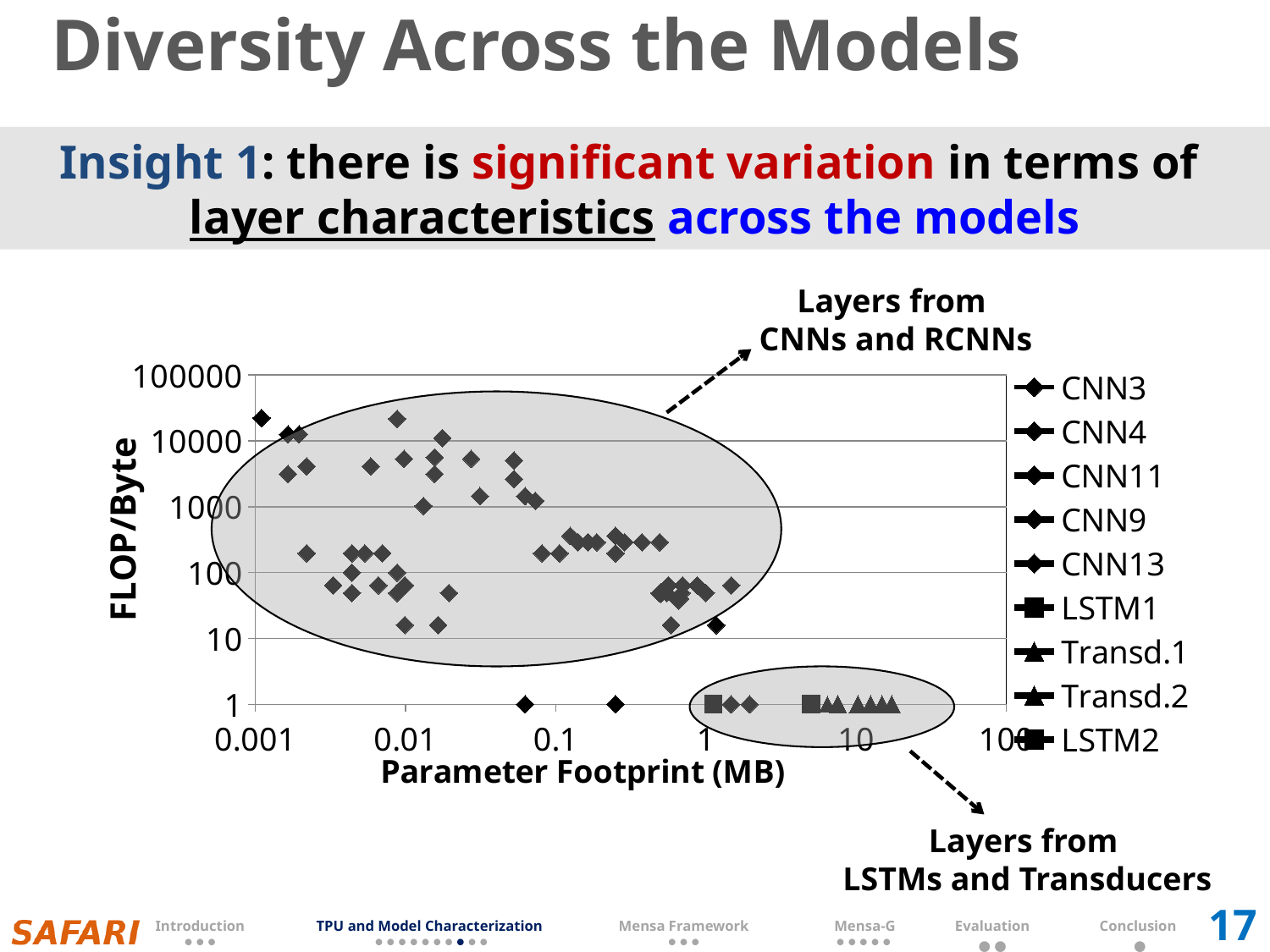
Are the parameter footprints of the layers from LSTMs and Transducers greater or less than 0.1 MB? greater What is the label of the x axis? Parameter Footprint (MB) Are the FLOP/Byte values for the layers from LSTMs and Transducers greater or less than 10? less What is the label of the y axis? FLOP/Byte How many series does the legend list? 9 What kind of chart is shown on the slide? scatter chart